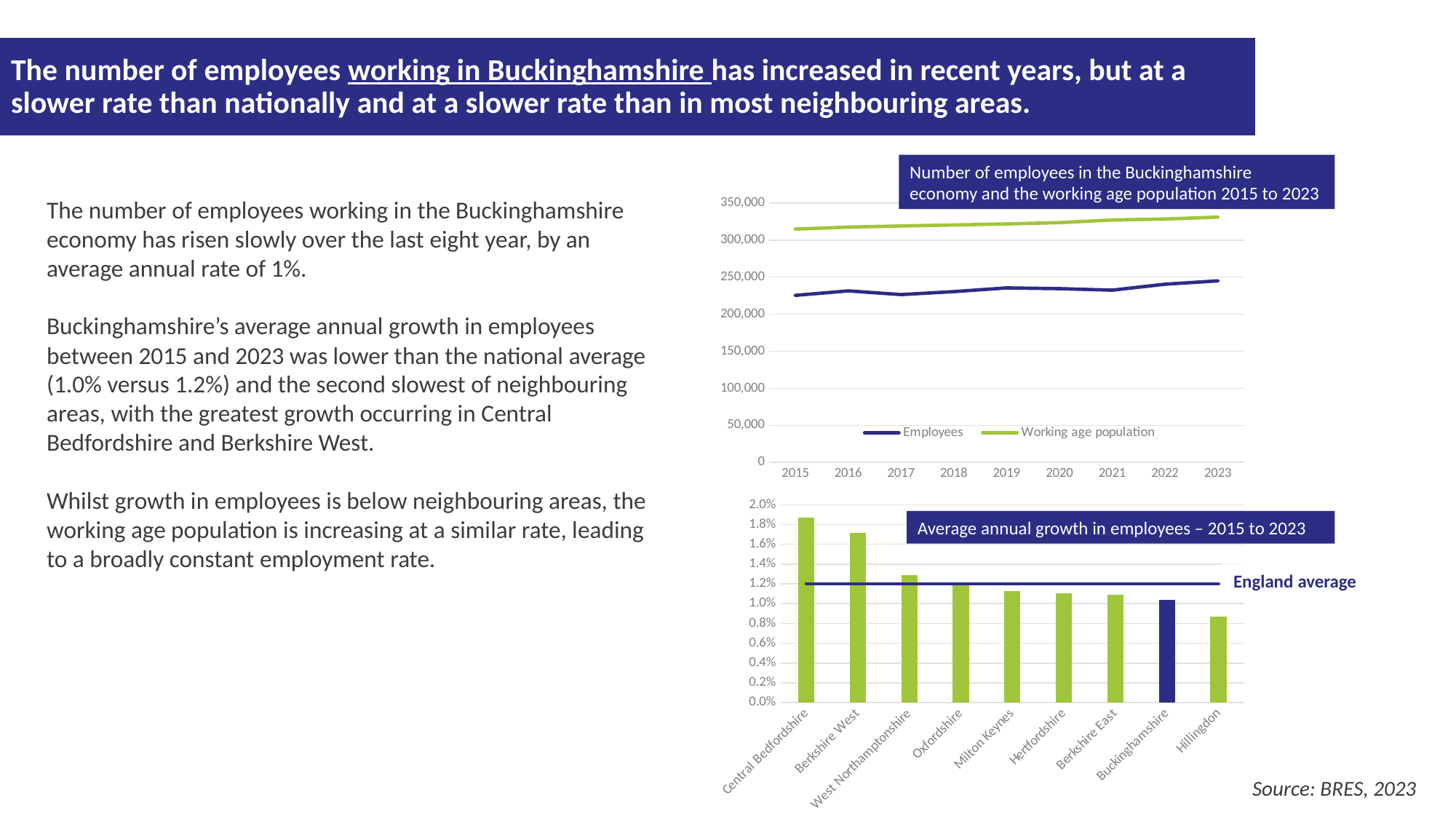
In the 'Average annual growth in employees – 2015 to 2023' chart, how many areas are shown? 9 In the 'Average annual growth in employees – 2015 to 2023' chart, which is larger, the value for Berkshire West or the value for West Northamptonshire? Berkshire West In the 'Average annual growth in employees – 2015 to 2023' chart, which area has the lowest average annual growth? Hillingdon In the 'Number of employees in the Buckinghamshire economy and the working age population 2015 to 2023' chart, does the working age population rise or fall from 2015 to 2023? rise In the 'Number of employees in the Buckinghamshire economy and the working age population 2015 to 2023' chart, is the working age population in 2015 greater or less than 300,000? greater What kind of chart is the 'Average annual growth in employees – 2015 to 2023' chart? bar chart In the 'Number of employees in the Buckinghamshire economy and the working age population 2015 to 2023' chart, how many years are shown on the x axis? 9 In the 'Number of employees in the Buckinghamshire economy and the working age population 2015 to 2023' chart, is the number of employees in 2023 greater or less than 250,000? less In the 'Average annual growth in employees – 2015 to 2023' chart, which area has the highest average annual growth? Central Bedfordshire What kind of chart is the 'Number of employees in the Buckinghamshire economy and the working age population 2015 to 2023' chart? line chart In the 'Average annual growth in employees – 2015 to 2023' chart, is the value for Buckinghamshire greater or less than 1.2%? less In the 'Number of employees in the Buckinghamshire economy and the working age population 2015 to 2023' chart, how many series does the legend list? 2